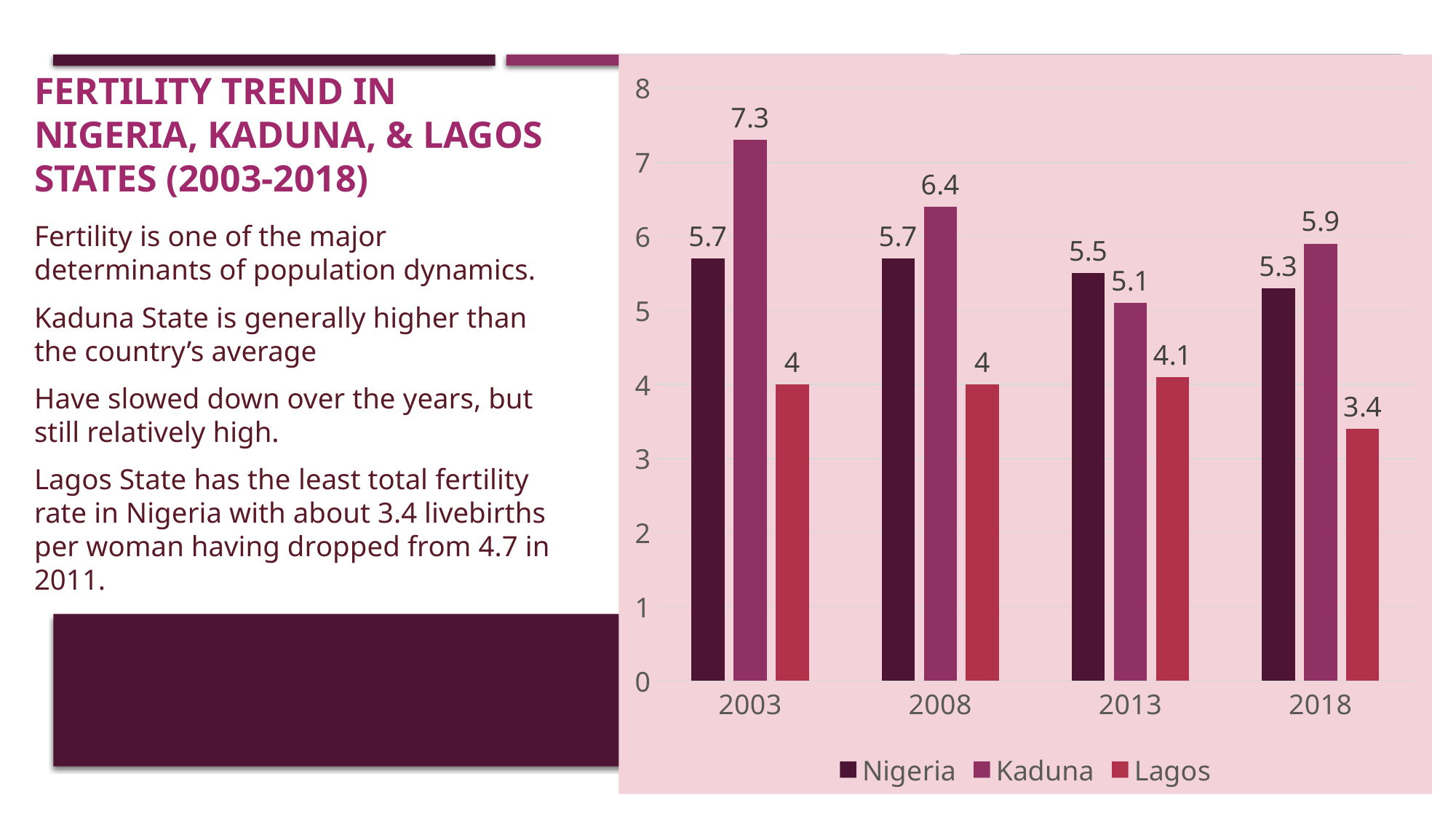
What is the difference between the Kaduna values in 2003 and 2018? 1.4 What is the difference between the Kaduna and Nigeria values in 2008? 0.7 In which year is the Kaduna value highest? 2003 What kind of chart is shown on the slide? Bar chart In which year is the Lagos value lowest? 2018 What is the value for Nigeria in 2013? 5.5 How many years are shown on the x axis? 4 What is the value for Lagos in 2018? 3.4 Do the Nigeria values rise or fall from 2003 to 2018? Fall How many series does the legend list? 3 What is the value for Kaduna in 2003? 7.3 Which is larger in 2013, the Nigeria value or the Kaduna value? Nigeria